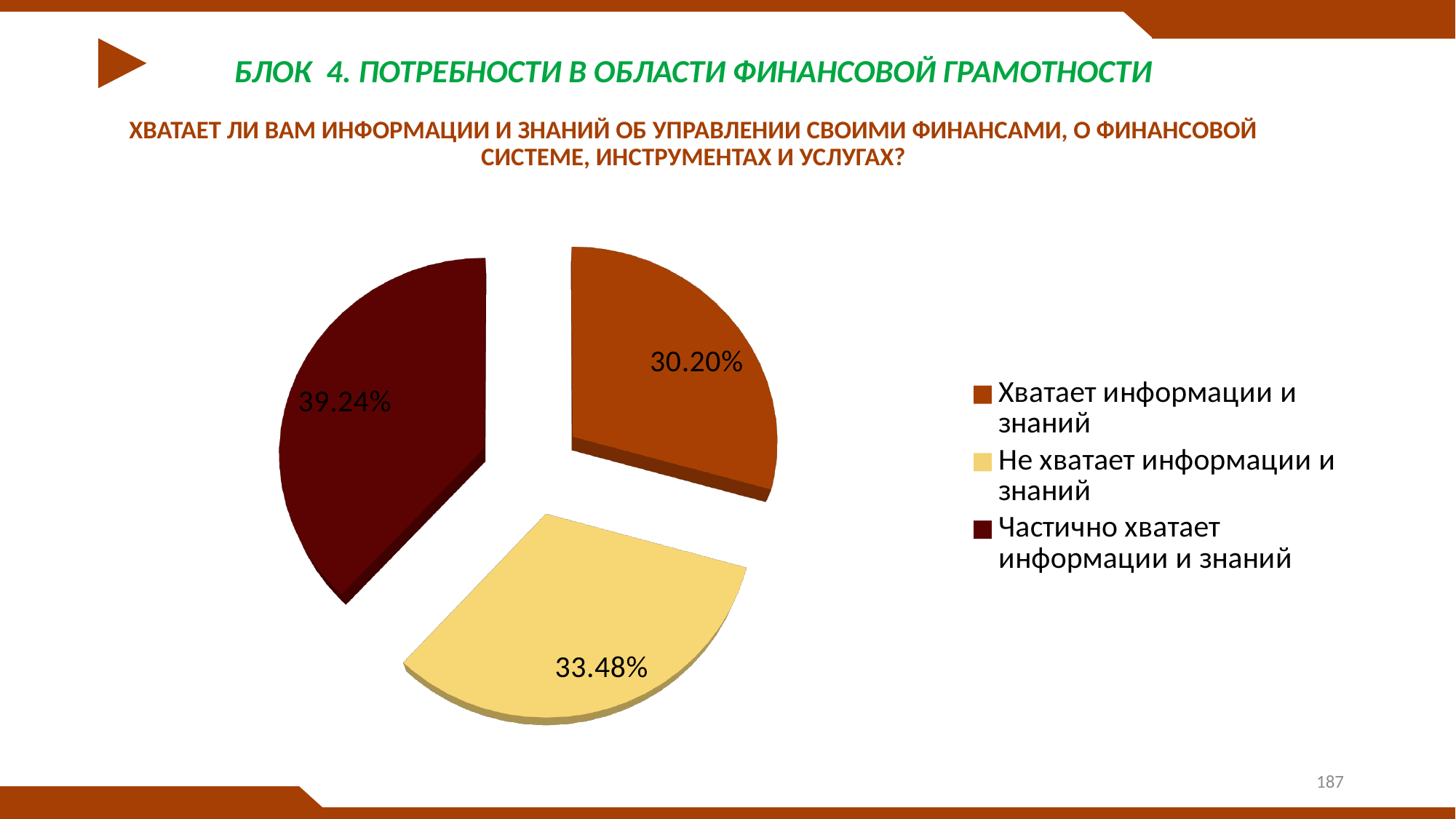
How many entries does the legend list? 3 What colour is the slice for "Не хватает информации и знаний"? yellow What share of respondents answered "Частично хватает информации и знаний"? 39.24% What share of respondents answered "Не хватает информации и знаний"? 33.48% Which is larger: the share for "Не хватает информации и знаний" or the share for "Хватает информации и знаний"? Не хватает информации и знаний What kind of chart is shown on the slide? pie chart What is the difference between the shares for "Не хватает информации и знаний" and "Хватает информации и знаний"? 3.28% Which answer option has the smallest share of the pie? Хватает информации и знаний How many slices does the pie chart have? 3 What is the difference between the shares for "Частично хватает информации и знаний" and "Хватает информации и знаний"? 9.04% Which answer option has the largest share of the pie? Частично хватает информации и знаний What share of respondents answered "Хватает информации и знаний"? 30.20%